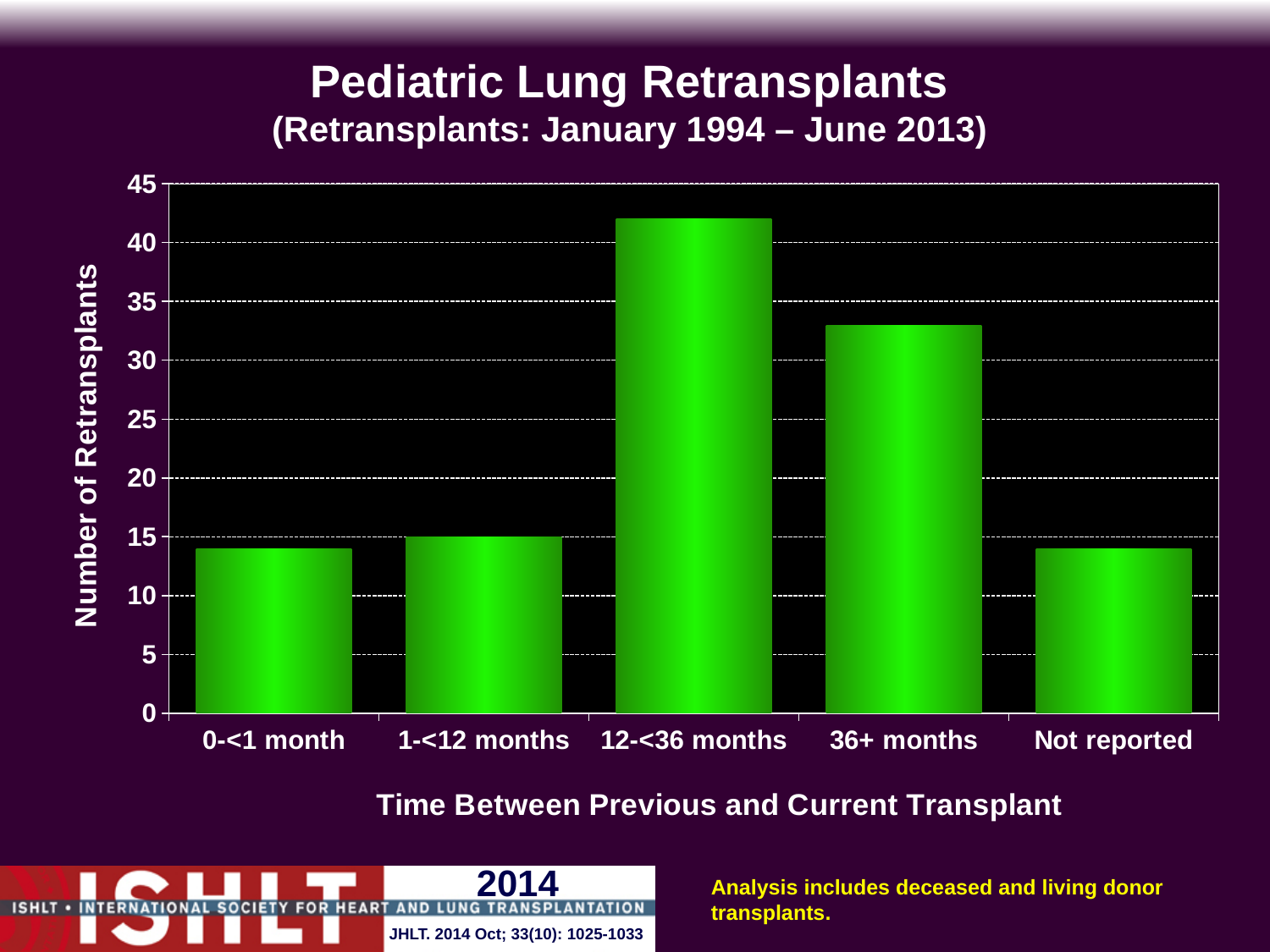
Which has more retransplants, 12-<36 months or 36+ months? 12-<36 months Which time-between-transplants category has the highest number of retransplants? 12-<36 months What is the label of the x axis of the chart? Time Between Previous and Current Transplant What is the label of the y axis of the chart? Number of Retransplants What type of chart is shown on the slide? bar chart Is the number of retransplants for 36+ months greater or less than 30? greater Is the number of retransplants for 36+ months greater or less than 35? less Is the number of retransplants for Not reported greater or less than 10? greater Which has more retransplants, 36+ months or 1-<12 months? 36+ months How many categories are shown on the x axis of the chart? 5